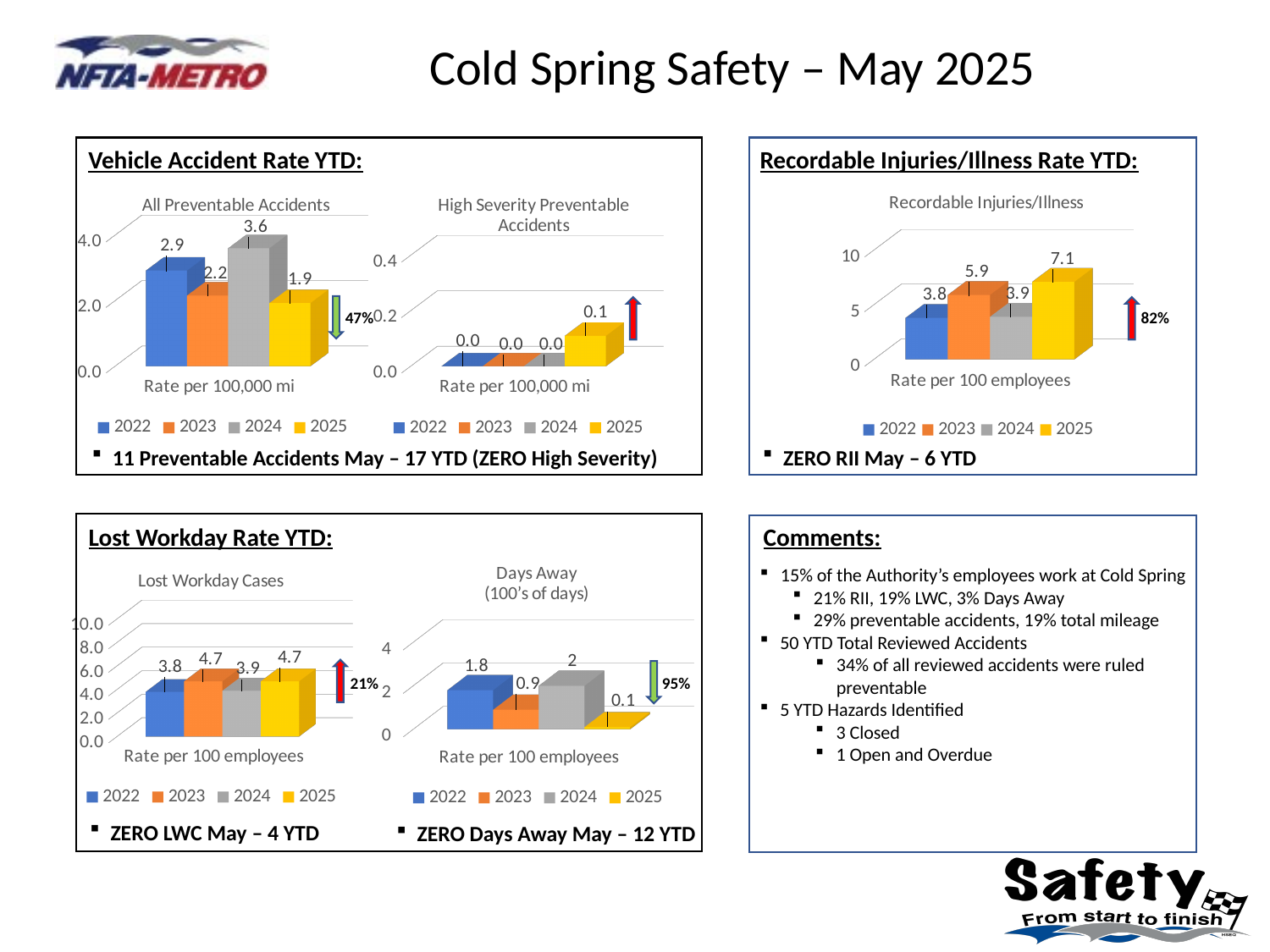
In the "Lost Workday Cases" chart, what is the value for 2022? 3.8 In the "Recordable Injuries/Illness" chart, is the value for 2022 larger or smaller than the value for 2023? smaller What kind of chart is the "Recordable Injuries/Illness" chart? bar chart In the "All Preventable Accidents" chart, which year has the lowest value? 2025 In the "High Severity Preventable Accidents" chart, what is the value for 2025? 0.1 How many series does the legend of the "Lost Workday Cases" chart list? 4 In the "Recordable Injuries/Illness" chart, which year has the highest value? 2025 In the "Recordable Injuries/Illness" chart, what is the value for 2023? 5.9 In the "All Preventable Accidents" chart, what is the difference between the 2024 and 2025 values? 1.7 In the "Days Away (100's of days)" chart, what is the difference between the 2022 and 2025 values? 1.7 In the "Days Away (100's of days)" chart, which year has the highest value? 2024 In the "All Preventable Accidents" chart, what is the value for 2024? 3.6